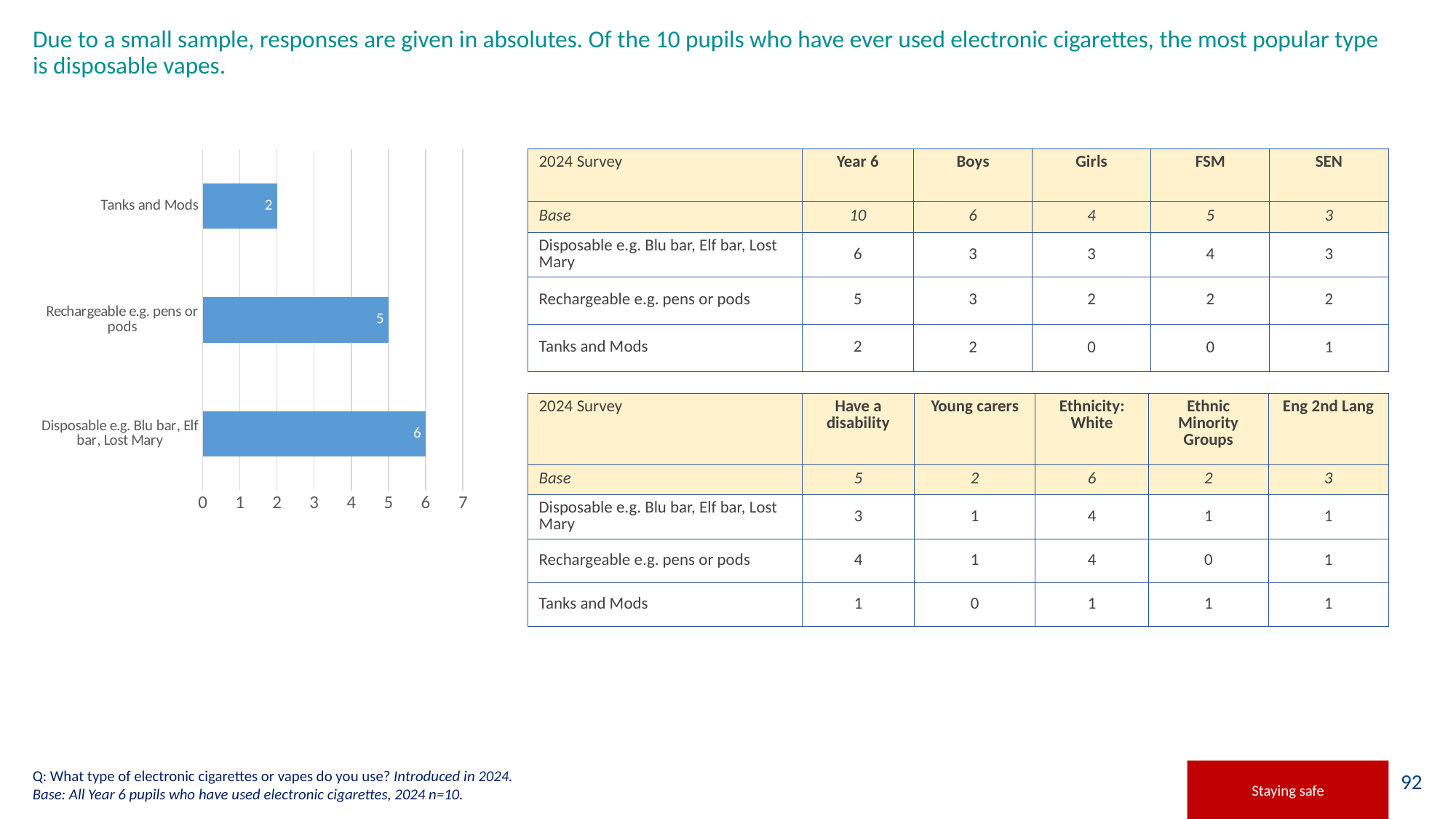
What is the value for Tanks and Mods in the bar chart? 2 What is the value for Disposable e.g. Blu bar, Elf bar, Lost Mary in the bar chart? 6 Which category has the highest value in the bar chart? Disposable e.g. Blu bar, Elf bar, Lost Mary Which is larger in the bar chart: Rechargeable e.g. pens or pods or Tanks and Mods? Rechargeable e.g. pens or pods Is the value for Rechargeable e.g. pens or pods greater or less than 3? greater How many categories are shown in the bar chart? 3 What is the difference between the values for Rechargeable e.g. pens or pods and Tanks and Mods in the bar chart? 3 What kind of chart is shown on the slide? bar chart Which category has the lowest value in the bar chart? Tanks and Mods What is the highest value shown on the x axis of the bar chart? 7 What is the value for Rechargeable e.g. pens or pods in the bar chart? 5 What is the difference between the values for Disposable e.g. Blu bar, Elf bar, Lost Mary and Tanks and Mods in the bar chart? 4